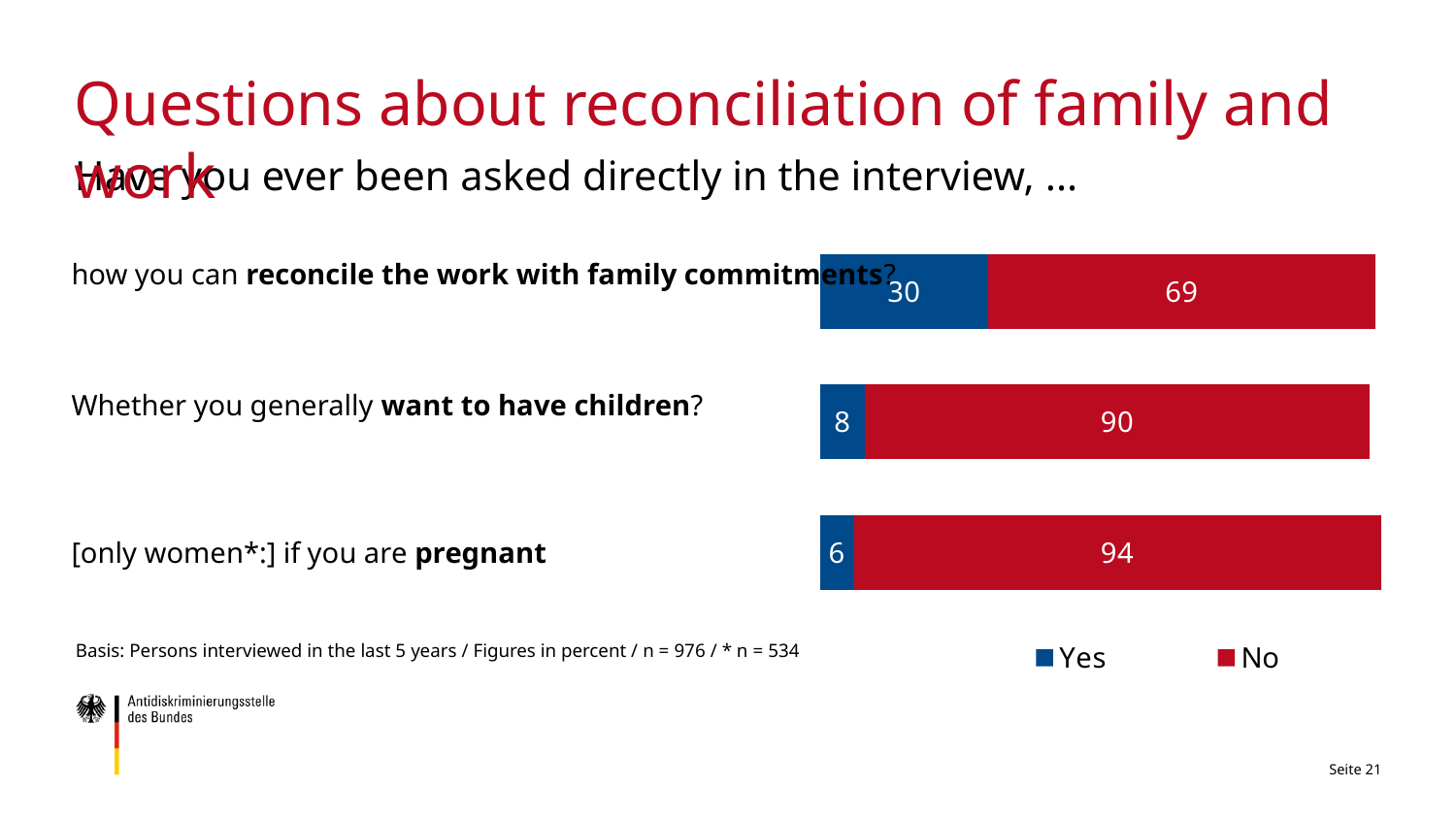
How many questions (categories) are shown in the chart? 3 Which question has the highest Yes share? how you can reconcile the work with family commitments? How many series does the legend list? 2 Which question has the lowest Yes share? [only women*:] if you are pregnant Which colour represents the No answers in the chart? red Is the Yes value larger for the question about wanting children or the question about being pregnant? want to have children What is the difference between the No values for the pregnancy question and the reconciling work with family question? 25 What is the No value for the question about reconciling work with family commitments? 69 What percentage answered Yes to being asked how they can reconcile the work with family commitments? 30 What is the Yes value for the question about being asked if you are pregnant? 6 What percentage answered No to being asked whether they generally want to have children? 90 What kind of chart is shown on the slide? stacked bar chart